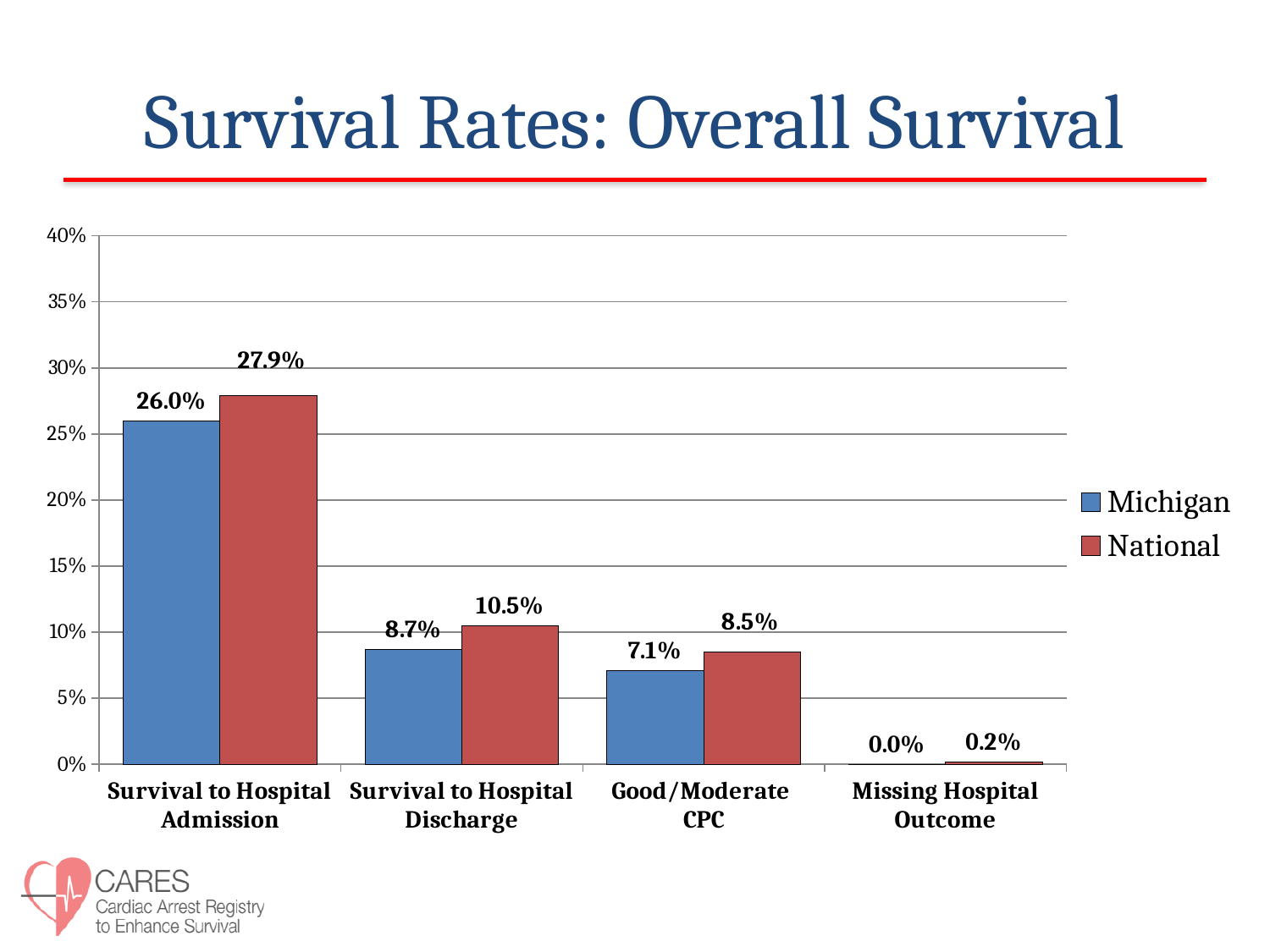
Which category has the highest National value? Survival to Hospital Admission Which category has the lowest Michigan value? Missing Hospital Outcome What is the difference between the National and Michigan values for Survival to Hospital Admission? 1.9% What kind of chart is shown on the slide? Bar chart What is the National value for Missing Hospital Outcome? 0.2% How many categories are shown on the x axis? 4 Which is larger for Good/Moderate CPC, the Michigan value or the National value? National What is the Michigan value for Survival to Hospital Admission? 26.0% What is the title of the slide? Survival Rates: Overall Survival How many series does the legend list? 2 What is the National value for Survival to Hospital Discharge? 10.5% What is the Michigan value for Good/Moderate CPC? 7.1%